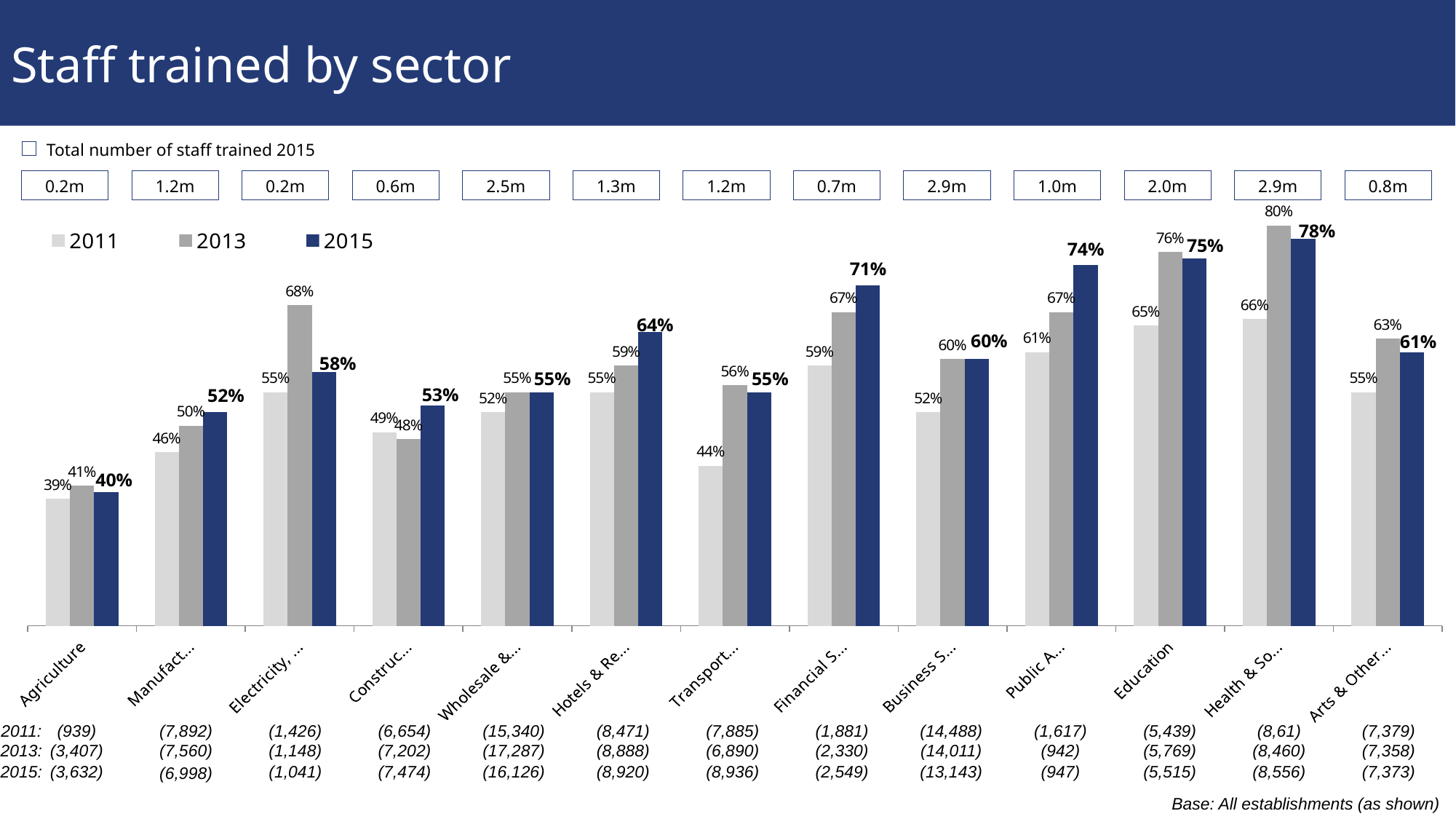
What percentage of staff were trained in Education in 2013? 76% By how much did the Education value rise from 2011 to 2013? 11 percentage points What was the 2015 value for Education? 75% Which is larger, the 2015 value for Education or the 2015 value for Agriculture? Education How many series does the legend list? 3 Which sector has the lowest 2015 value? Agriculture What was the 2011 value for Agriculture? 39% What kind of chart is shown on the slide? Bar chart What is the difference between the 2015 values for Education and Agriculture? 35 percentage points What percentage of staff were trained in Agriculture in 2015? 40% What is the total number of staff trained in 2015 shown above the Education bars? 2.0m How many sectors are shown on the x axis? 13